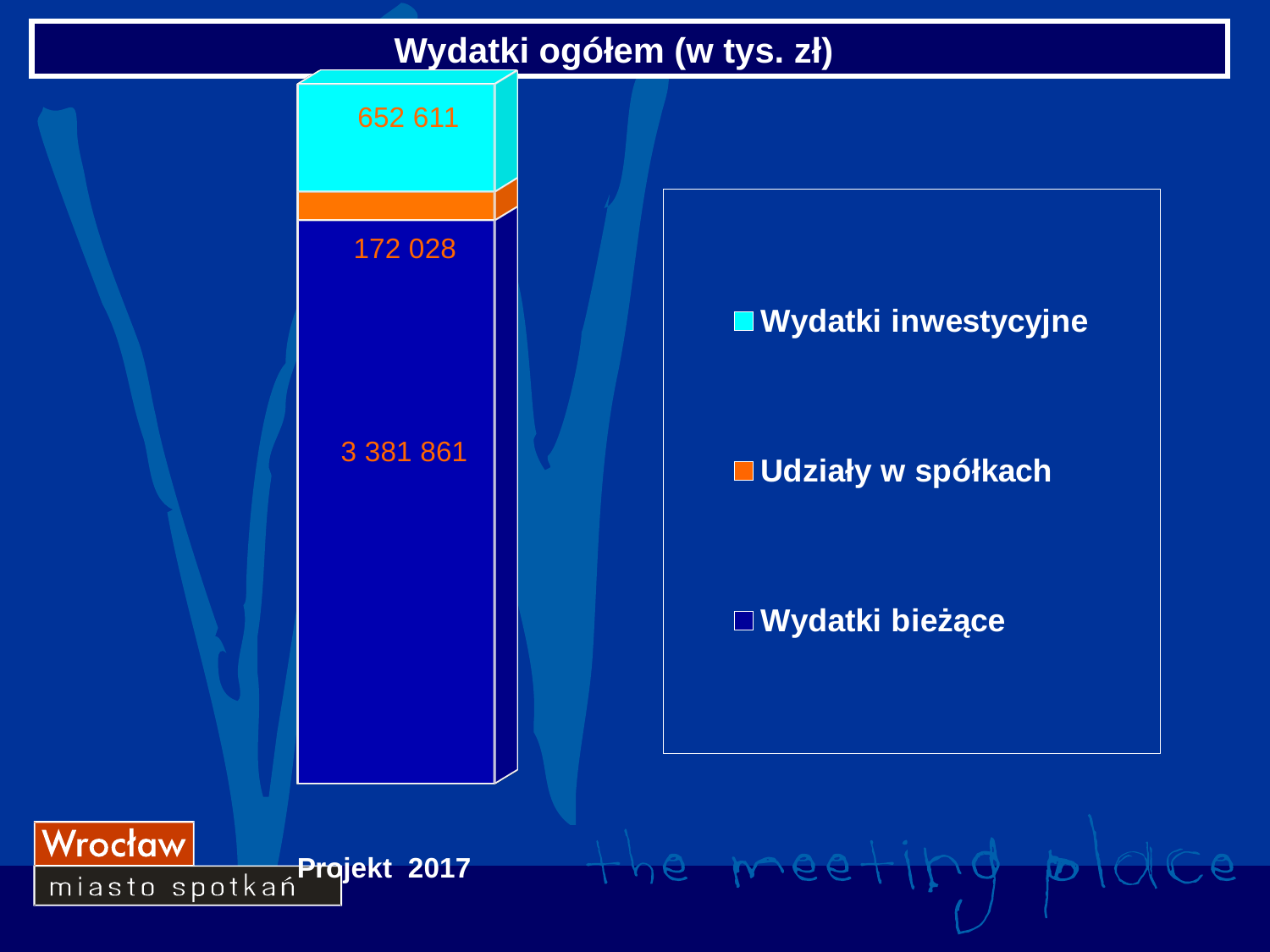
Which series has the largest value in the chart? Wydatki bieżące What is the title of the chart? Wydatki ogółem (w tys. zł) What is the total of the stacked bar in the chart? 4 206 500 What is the value of the Wydatki bieżące segment in the chart? 3 381 861 What is the value of the Wydatki inwestycyjne segment in the chart? 652 611 Which is larger, Wydatki inwestycyjne or Udziały w spółkach? Wydatki inwestycyjne What is the value of the Udziały w spółkach segment in the chart? 172 028 What is the difference between the Wydatki bieżące and Wydatki inwestycyjne values? 2 729 250 What kind of chart is shown on the slide? Stacked bar chart How many series does the legend list? 3 What is the difference between the Wydatki inwestycyjne and Udziały w spółkach values? 480 583 Which series has the smallest value in the chart? Udziały w spółkach